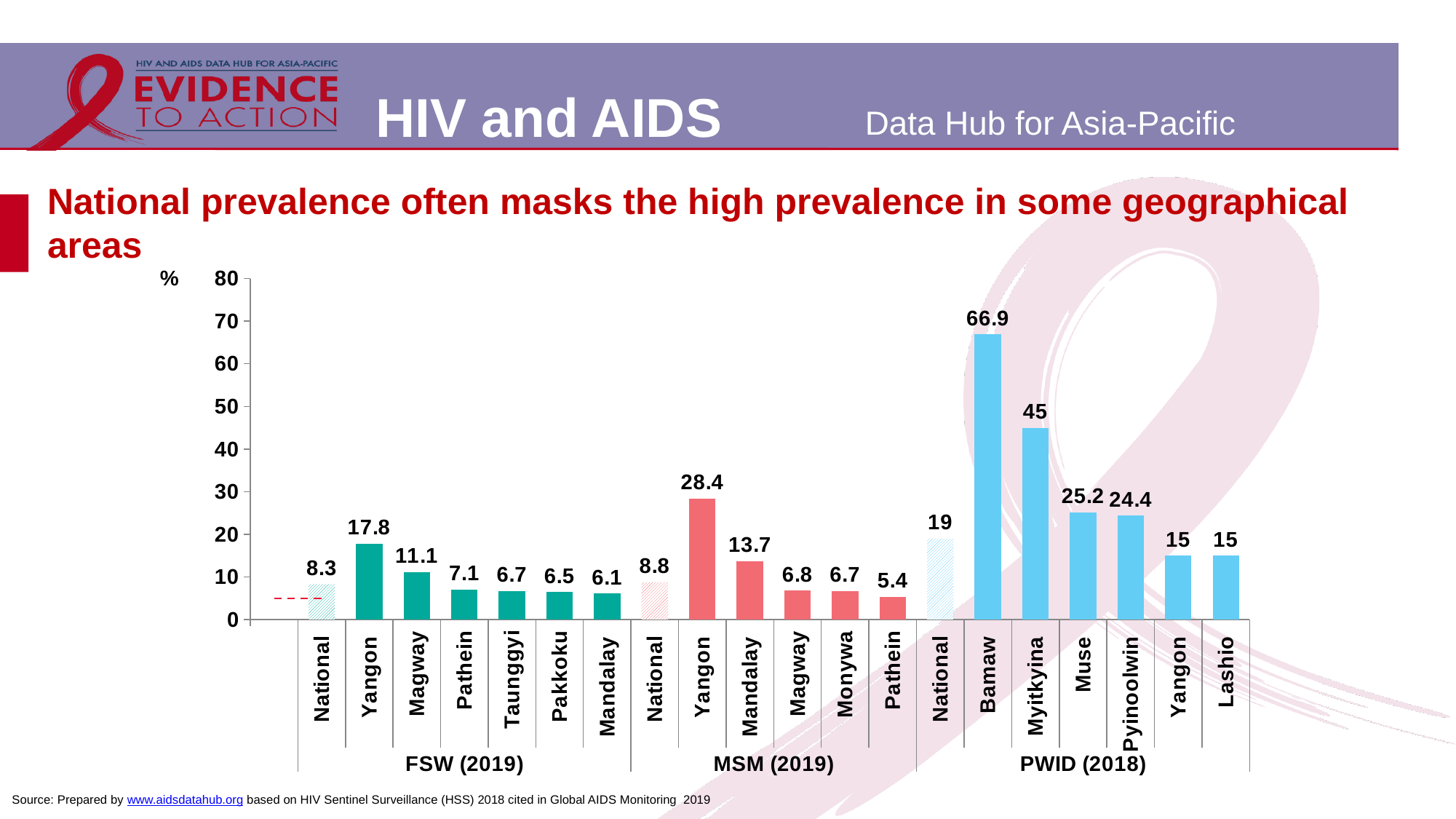
Which category has the highest value on the chart? Bamaw Which is larger, the Yangon value in the FSW (2019) group or the Yangon value in the MSM (2019) group? Yangon in MSM (2019) What is the difference between the Muse and Pyinoolwin values in the PWID (2018) group? 0.8 Is the value for Myitkyina greater or less than 40? greater What is the difference between the Bamaw value and the National value in the PWID (2018) group? 47.9 What kind of chart is shown on the slide? bar chart What is the value for Yangon in the MSM (2019) group? 28.4 What is the value for Bamaw in the PWID (2018) group? 66.9 Which category has the lowest value in the MSM (2019) group? Pathein What is the National value in the FSW (2019) group? 8.3 What are the three population groups labelled along the x axis? FSW (2019), MSM (2019), PWID (2018) How many bars are plotted on the chart in total? 20